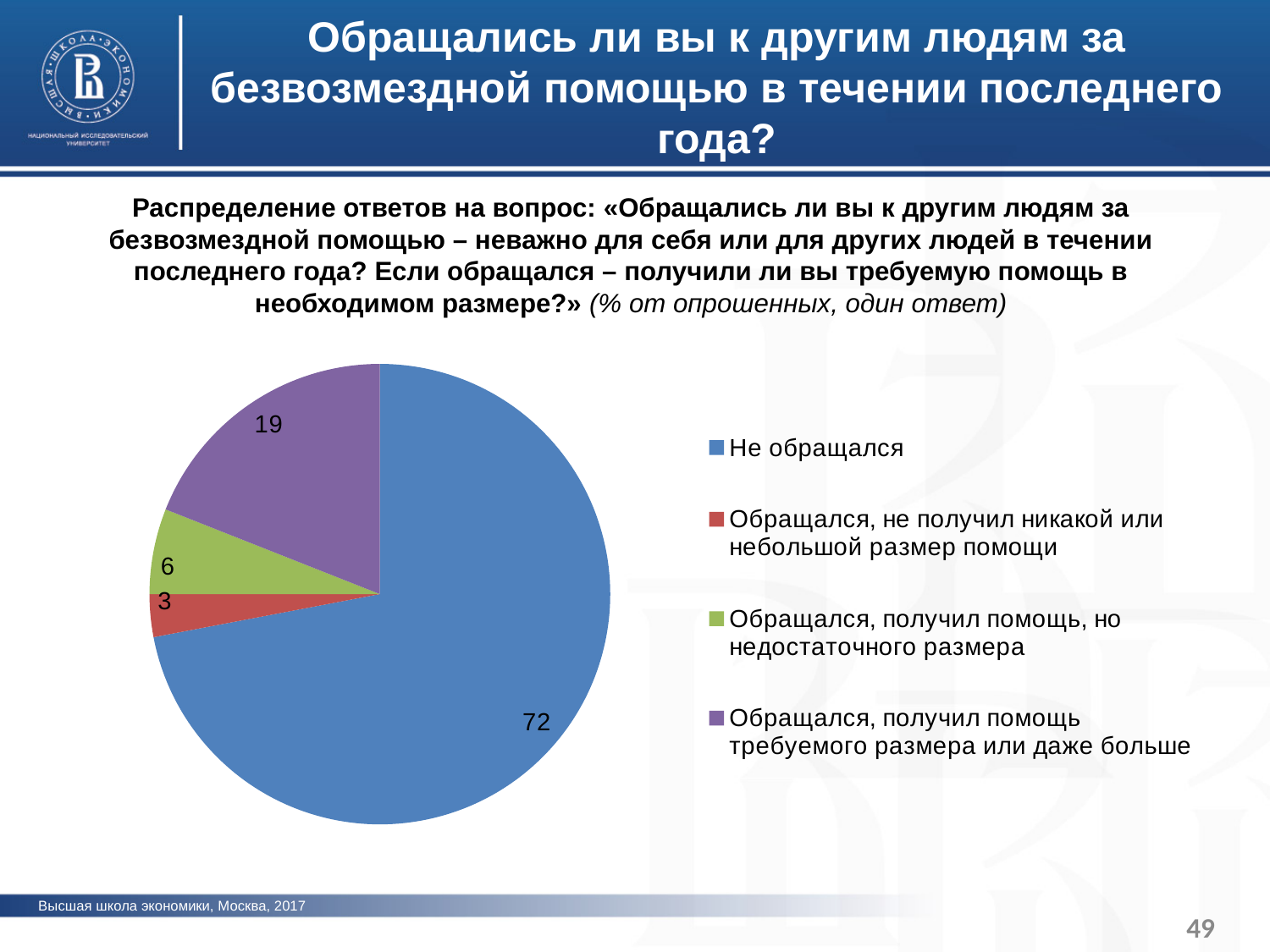
Which is larger: the value for «Обращался, получил помощь, но недостаточного размера» or the value for «Обращался, не получил никакой или небольшой размер помощи»? Обращался, получил помощь, но недостаточного размера What kind of chart is shown on the slide? pie chart Which category has the smallest slice of the pie? Обращался, не получил никакой или небольшой размер помощи What is the value for «Не обращался»? 72 What is the value for «Обращался, получил помощь требуемого размера или даже больше»? 19 What colour is the slice for «Не обращался»? blue What is the difference between the values for «Не обращался» and «Обращался, получил помощь требуемого размера или даже больше»? 53 How many entries does the legend list? 4 Which category has the largest slice of the pie? Не обращался How many slices does the pie chart have? 4 What is the value for «Обращался, получил помощь, но недостаточного размера»? 6 What is the value for «Обращался, не получил никакой или небольшой размер помощи»? 3